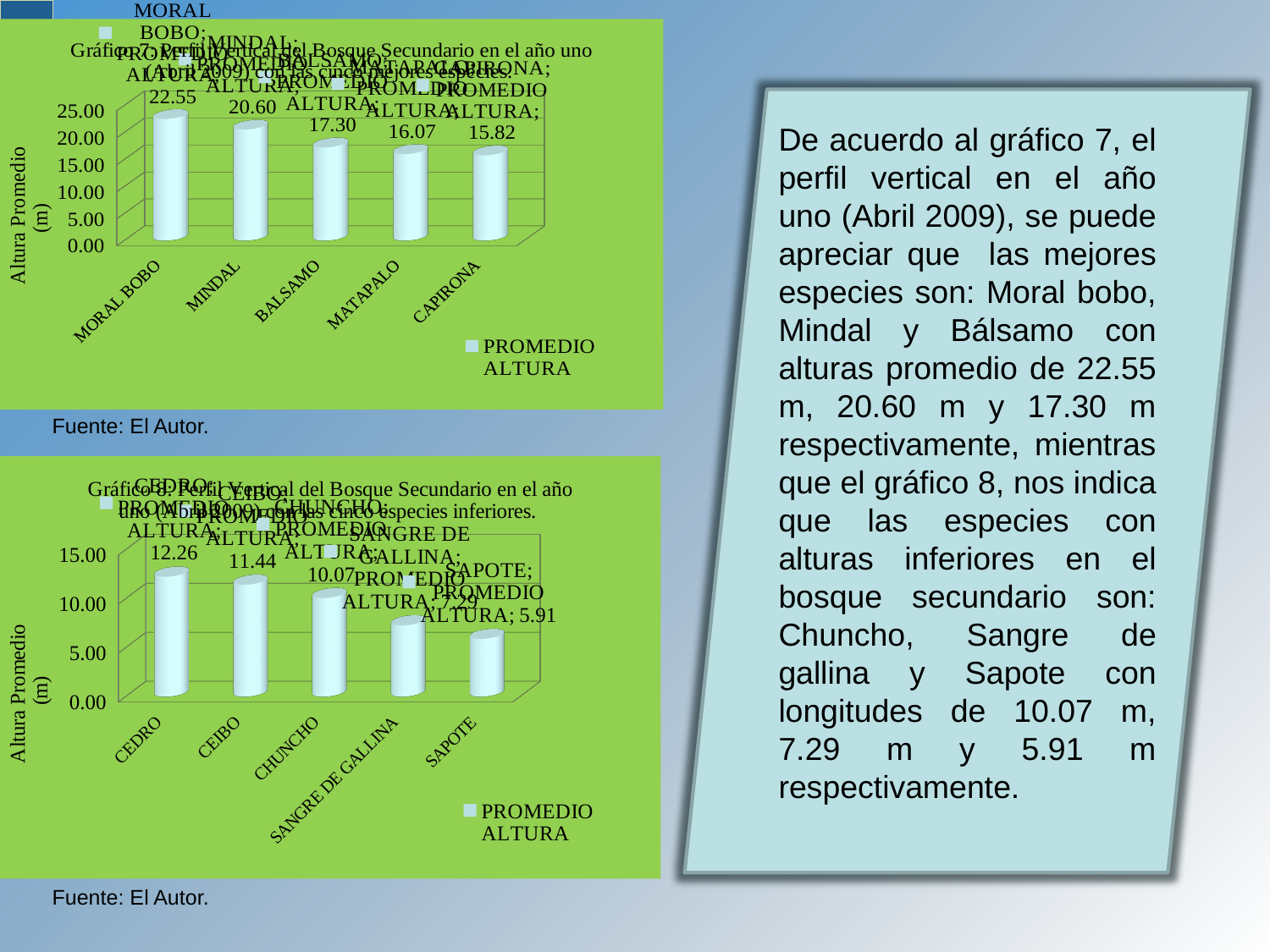
In the bottom chart (Gráfico 8), what is the value for CEDRO? 12.26 In the top chart (Gráfico 7), what is the difference between the values for MORAL BOBO and MINDAL? 1.95 In the top chart (Gráfico 7), how many species are plotted? 5 In the bottom chart (Gráfico 8), what is the value for SANGRE DE GALLINA? 7.29 In the top chart (Gráfico 7), which species has the lowest average height? CAPIRONA In the bottom chart (Gráfico 8), which is larger, the value for CHUNCHO or the value for SAPOTE? CHUNCHO In the bottom chart (Gráfico 8), which species has the highest average height? CEDRO In the top chart (Gráfico 7), what is the PROMEDIO ALTURA value for MORAL BOBO? 22.55 How many series does the legend of the top chart (Gráfico 7) list? 1 In the top chart (Gráfico 7), what is the value for BALSAMO? 17.30 What type of chart is the bottom chart (Gráfico 8)? bar chart In the top chart (Gráfico 7), do the values rise or fall from left to right along the x axis? fall